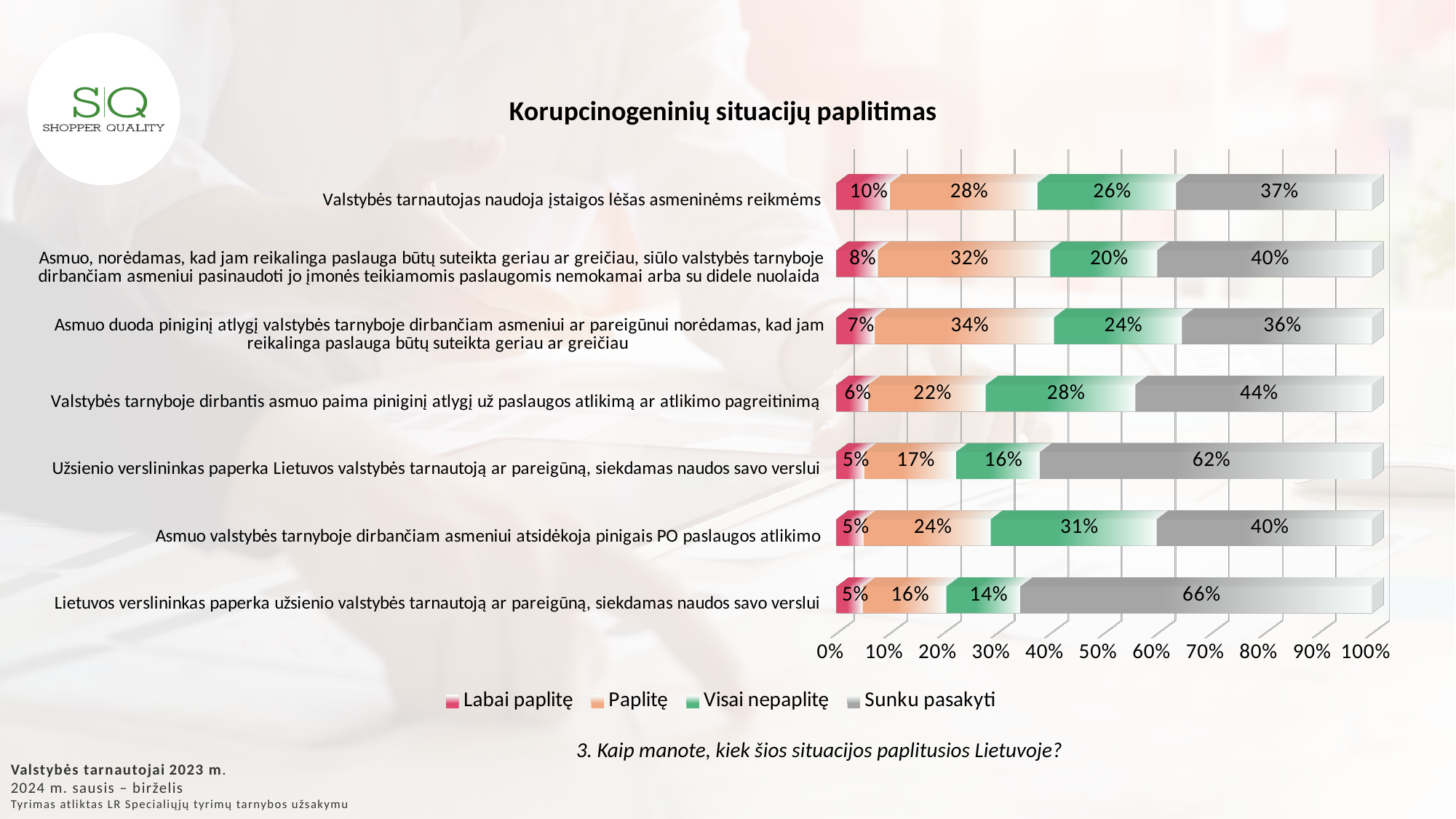
What is the 'Sunku pasakyti' value for 'Lietuvos verslininkas paperka užsienio valstybės tarnautoją ar pareigūną, siekdamas naudos savo verslui'? 66% How many categories (situations) are plotted in the chart? 7 Which is larger: the 'Paplitę' value for 'Asmuo, norėdamas, kad jam reikalinga paslauga būtų suteikta geriau ar greičiau...' or for 'Valstybės tarnautojas naudoja įstaigos lėšas asmeninėms reikmėms'? Asmuo, norėdamas, kad jam reikalinga paslauga būtų suteikta geriau ar greičiau... (32%) What is the 'Paplitę' value for 'Asmuo duoda piniginį atlygį valstybės tarnyboje dirbančiam asmeniui ar pareigūnui norėdamas, kad jam reikalinga paslauga būtų suteikta geriau ar greičiau'? 34% What is the title of the chart? Korupcinogeninių situacijų paplitimas Which category has the highest 'Visai nepaplitę' value? Asmuo valstybės tarnyboje dirbančiam asmeniui atsidėkoja pinigais PO paslaugos atlikimo What is the 'Labai paplitę' value for 'Valstybės tarnautojas naudoja įstaigos lėšas asmeninėms reikmėms'? 10% What is the combined share of 'Labai paplitę' and 'Paplitę' for 'Valstybės tarnyboje dirbantis asmuo paima piniginį atlygį už paslaugos atlikimą ar atlikimo pagreitinimą'? 28% What is the difference between the 'Sunku pasakyti' values for 'Užsienio verslininkas paperka Lietuvos valstybės tarnautoją ar pareigūną, siekdamas naudos savo verslui' and 'Valstybės tarnyboje dirbantis asmuo paima piniginį atlygį už paslaugos atlikimą ar atlikimo pagreitinimą'? 18% How many series does the legend list? 4 What type of chart is shown on the slide? Stacked bar chart Which category has the lowest 'Sunku pasakyti' value? Asmuo duoda piniginį atlygį valstybės tarnyboje dirbančiam asmeniui ar pareigūnui norėdamas, kad jam reikalinga paslauga būtų suteikta geriau ar greičiau